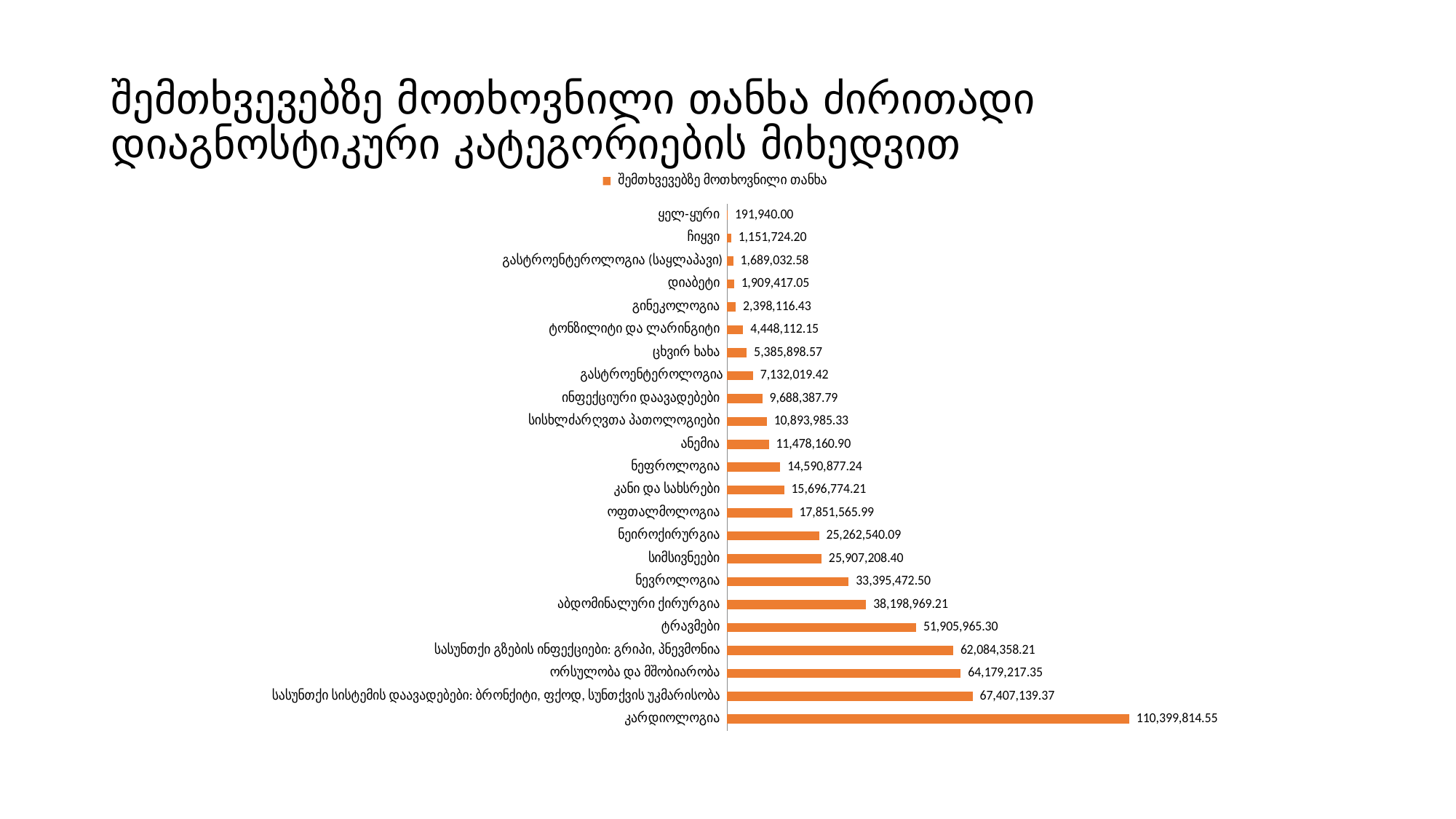
Which is larger, the value for ნეფროლოგია or the value for ოფთალმოლოგია? ოფთალმოლოგია How many categories are plotted in the chart? 23 What is the difference between the values for კარდიოლოგია and ორსულობა და მშობიარობა? 46,220,597.20 What is the legend entry shown above the chart? შემთხვევებზე მოთხოვნილი თანხა How many series does the legend list? 1 What is the difference between the values for ტრავმები and ნევროლოგია? 18,510,492.80 Which category has the lowest value? ყელ-ყური What is the value for ანემია? 11,478,160.90 Which category has the highest value? კარდიოლოგია What is the value for ტრავმები? 51,905,965.30 What type of chart is shown on the slide? bar chart What is the value for კარდიოლოგია? 110,399,814.55